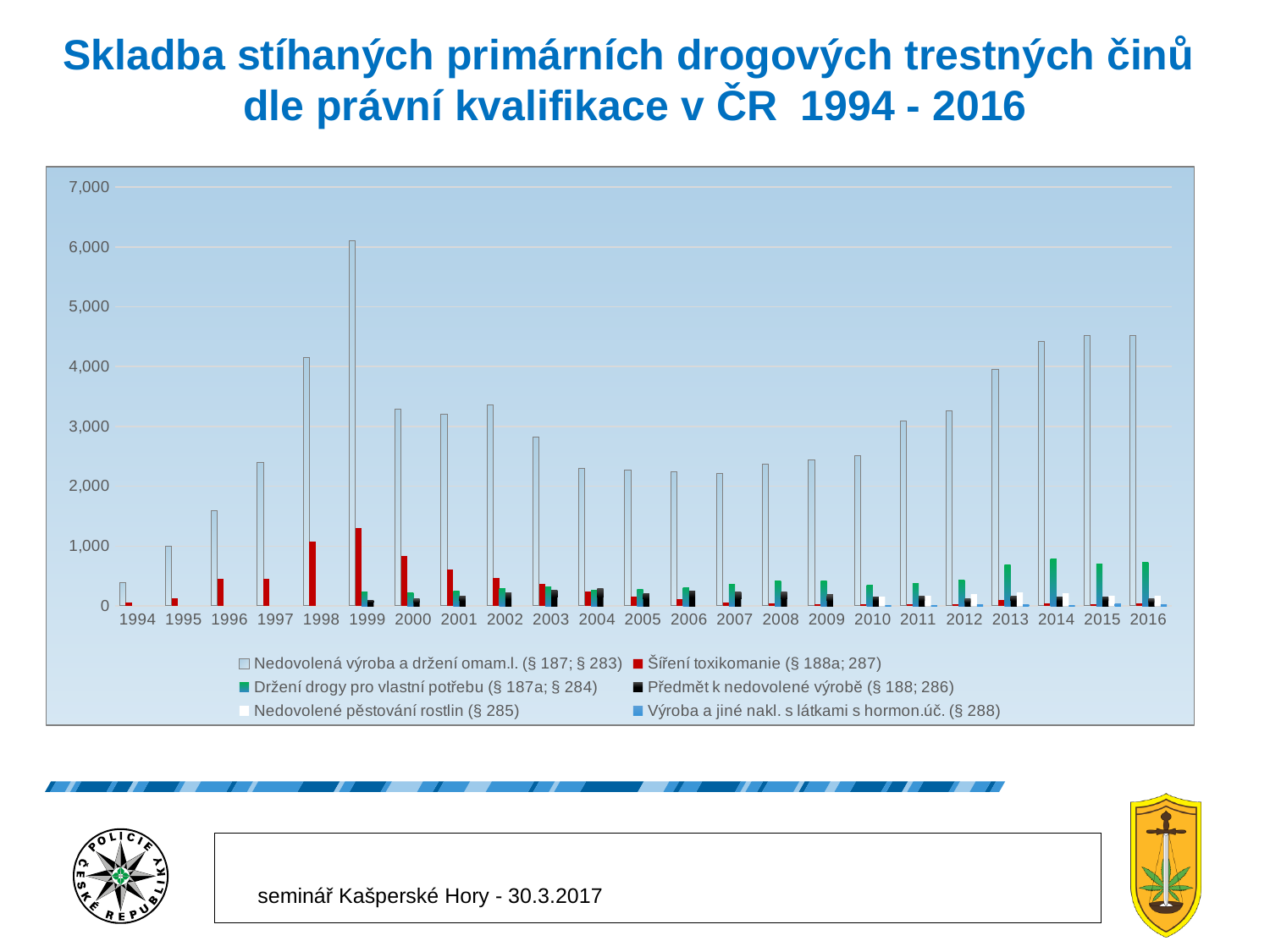
How many years are shown on the x axis? 23 Which is larger for Nedovolená výroba a držení omam.l. (§ 187; § 283): the value in 1998 or in 2000? 1998 Which series is shown in red in the legend? Šíření toxikomanie (§ 188a; 287) In which year is the value for Šíření toxikomanie (§ 188a; 287) highest? 1999 Is the value for Šíření toxikomanie (§ 188a; 287) in 1999 greater or less than 1,000? greater What kind of chart is shown on the slide? bar chart Is the value for Nedovolená výroba a držení omam.l. (§ 187; § 283) in 1999 greater or less than 5,000? greater How many series does the legend list? 6 Does the value for Nedovolená výroba a držení omam.l. (§ 187; § 283) rise or fall from 1994 to 1999? rise In which year is the value for Nedovolená výroba a držení omam.l. (§ 187; § 283) lowest? 1994 In which year is the value for Nedovolená výroba a držení omam.l. (§ 187; § 283) highest? 1999 Is the value for Nedovolená výroba a držení omam.l. (§ 187; § 283) in 1994 greater or less than 1,000? less